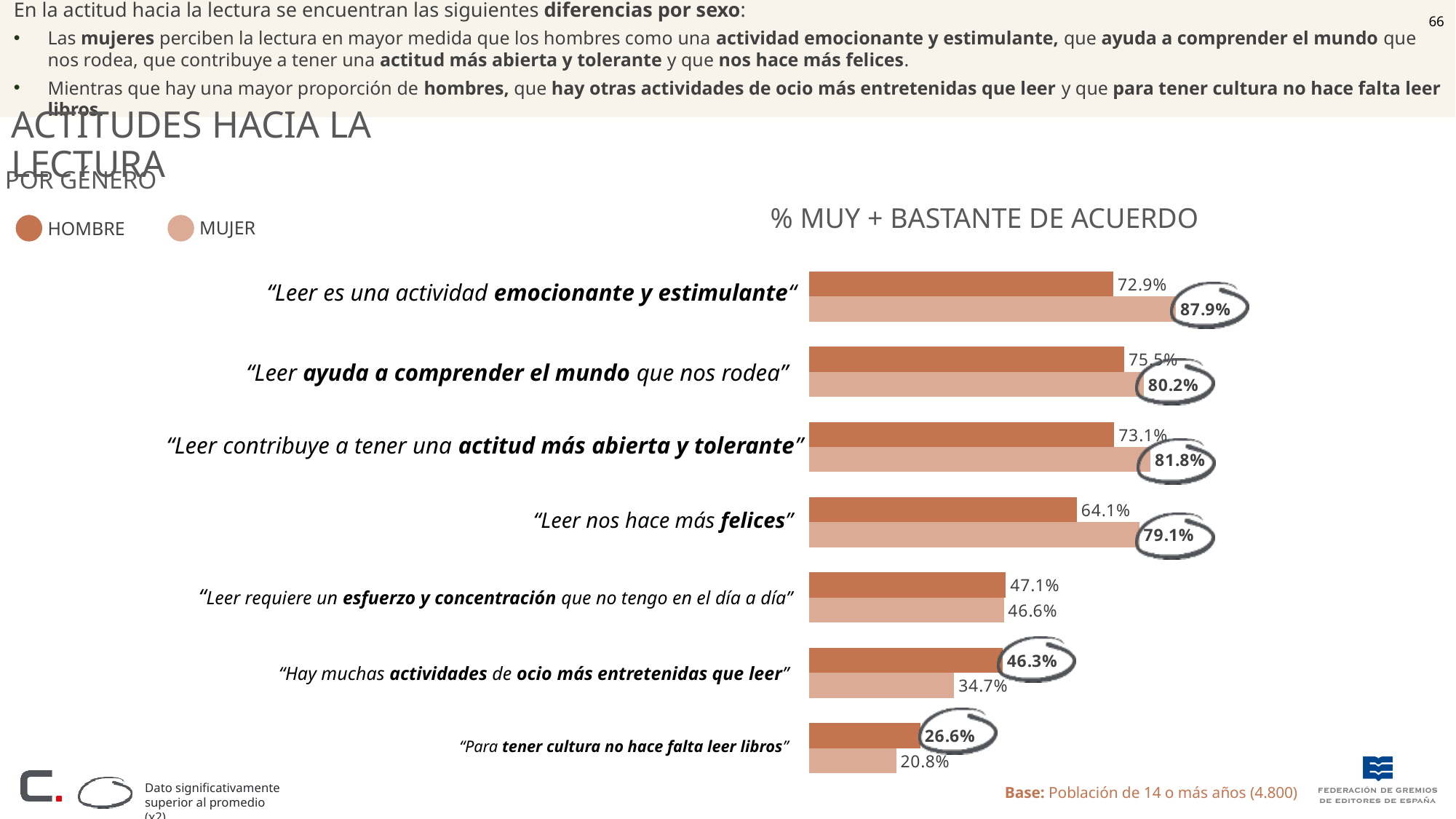
What is the MUJER value for "Leer es una actividad emocionante y estimulante"? 87.9% What is the difference between the MUJER and HOMBRE values for "Leer nos hace más felices"? 15.0 percentage points How many statements (categories) are plotted in the chart? 7 Which statement has the highest MUJER value? "Leer es una actividad emocionante y estimulante" What is the title shown above the chart? % MUY + BASTANTE DE ACUERDO Which statement has the lowest HOMBRE value? "Para tener cultura no hace falta leer libros" What is the HOMBRE value for "Para tener cultura no hace falta leer libros"? 26.6% How many series does the legend list? 2 For "Hay muchas actividades de ocio más entretenidas que leer", which is larger, the HOMBRE value or the MUJER value? HOMBRE What is the MUJER value for "Hay muchas actividades de ocio más entretenidas que leer"? 34.7% What is the HOMBRE value for "Leer nos hace más felices"? 64.1% What type of chart is shown on the slide? bar chart